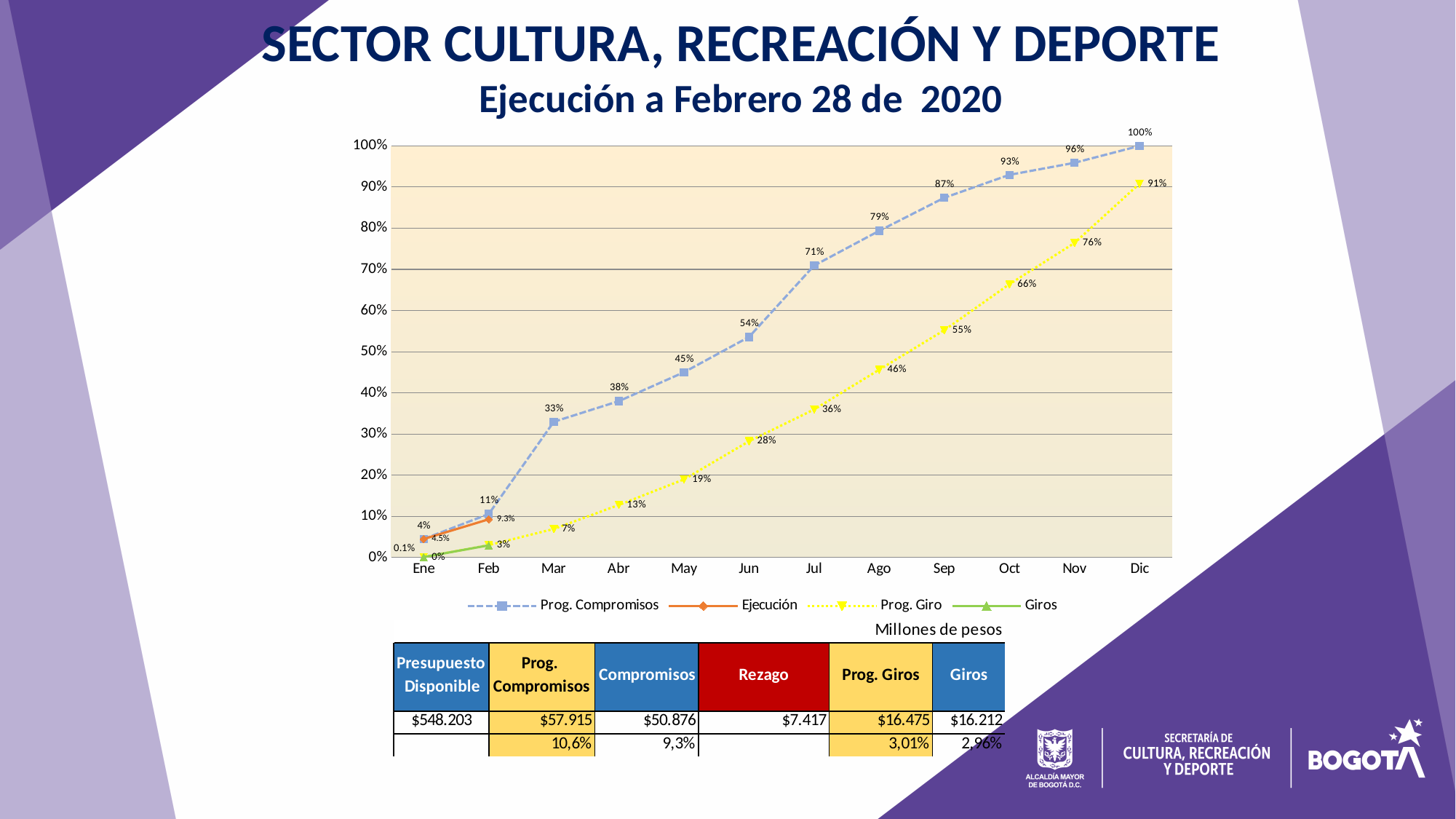
In which month does Prog. Compromisos reach its highest value? Dic In Jun, which is larger: Prog. Compromisos or Prog. Giro? Prog. Compromisos What is the difference between Prog. Compromisos and Prog. Giro in Dic? 9 percentage points Does the Prog. Giro series rise or fall from Ene to Dic? Rise How many series does the chart legend list? 4 What is the value of Prog. Giro in Ago? 46% What is the value of Prog. Compromisos in Jul? 71% What is the value of Ejecución in Feb? 9.3% What is the value of Prog. Giro in Dic? 91% What kind of chart is shown on the slide? Line chart Which series in the legend is drawn with a green line and triangle markers? Giros How many months are shown on the x axis of the chart? 12